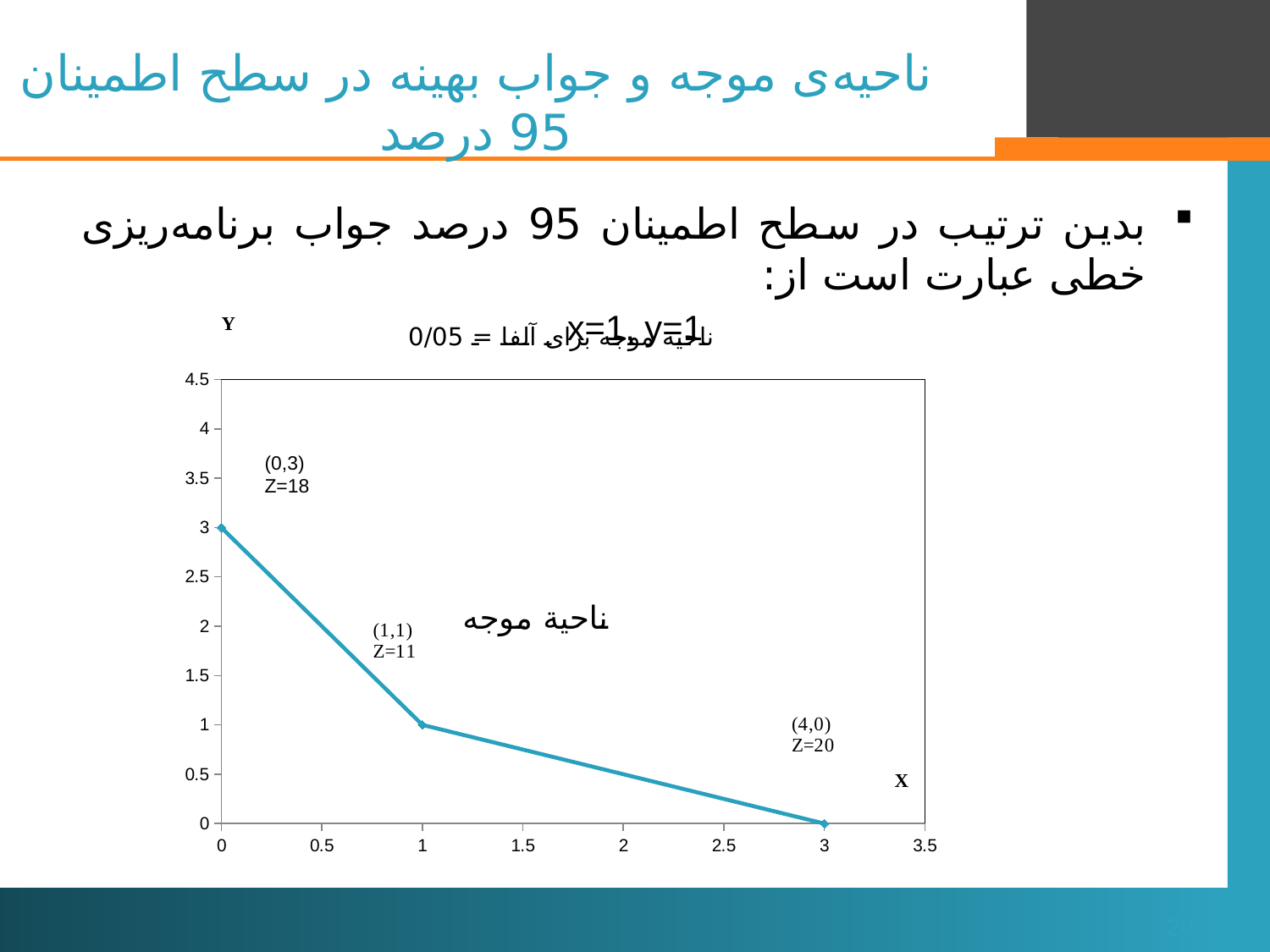
How many data points are plotted on the line? 3 Which labelled point has the highest Z value? (4,0) What is the Z value labelled at the point (0,3)? Z=18 What is the y value of the plotted point at x = 0? 3 What kind of chart is shown on the slide? line chart Does the plotted line rise or fall as x increases? fall What is the Z value labelled at the point (4,0)? Z=20 Which labelled point has the lowest Z value? (1,1) Which is larger, the Z value at (0,3) or the Z value at (1,1)? Z at (0,3) What is the Z value labelled at the point (1,1)? Z=11 What is the difference between the Z values at (0,3) and (1,1)? 7 What is the difference between the Z values at (4,0) and (0,3)? 2